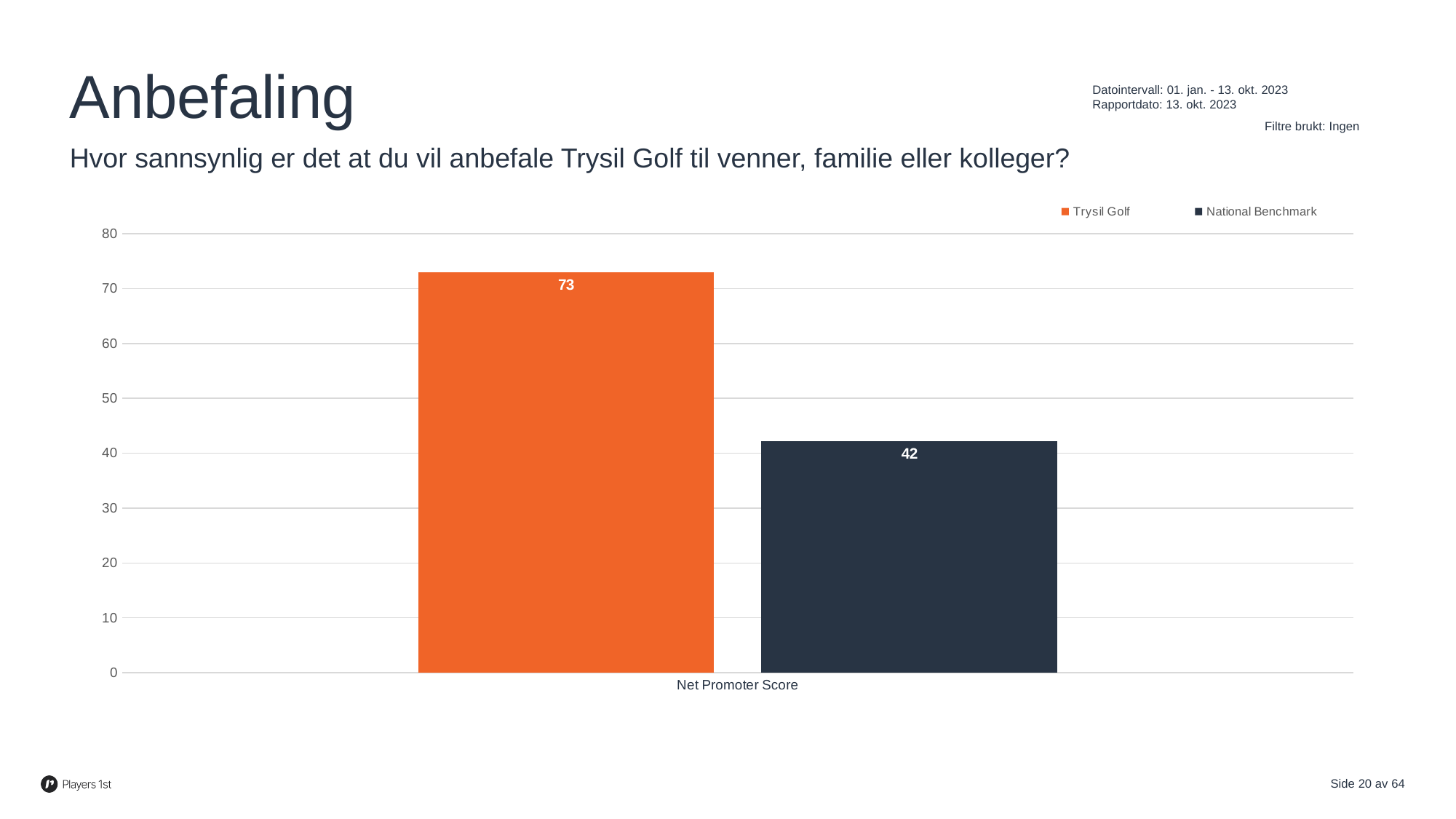
How many series does the legend list? 2 What is the difference between the Trysil Golf score and the National Benchmark score? 31 Is the value for Trysil Golf greater or less than 70? greater How many categories are shown on the x axis? 1 What is the Net Promoter Score for Trysil Golf? 73 Which series has the lowest value in the chart? National Benchmark What is the label of the category on the x axis? Net Promoter Score Is the value for National Benchmark greater or less than 50? less What is the Net Promoter Score for the National Benchmark? 42 What kind of chart is shown on the slide? Bar chart What colour is the bar for Trysil Golf? Orange Which series has the higher Net Promoter Score, Trysil Golf or National Benchmark? Trysil Golf